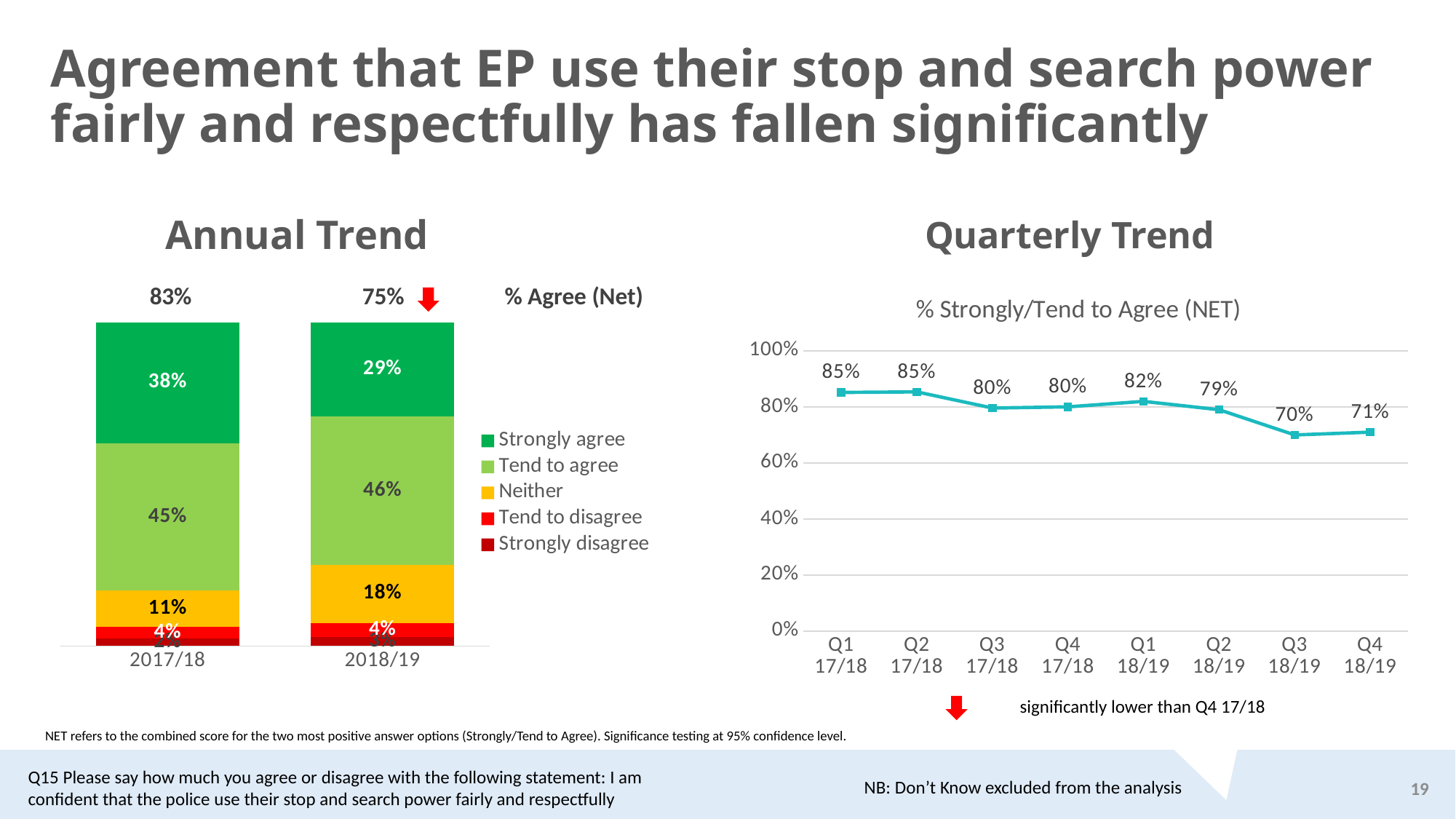
How many quarters are plotted in the Quarterly Trend chart? 8 In the Annual Trend chart, which year has the larger Tend to agree value, 2017/18 or 2018/19? 2018/19 In the Quarterly Trend chart, which quarter has the lowest value? Q3 18/19 What kind of chart is the Quarterly Trend chart? Line chart In the Annual Trend chart, what is the Strongly agree value for 2018/19? 29% How many series does the legend of the Annual Trend chart list? 5 In the Annual Trend chart, what is the % Agree (Net) for 2017/18? 83% In the Quarterly Trend chart, what is the value for Q3 18/19? 70% In the Annual Trend chart, what is the Neither value for 2018/19? 18% In the Quarterly Trend chart, what is the difference between Q1 17/18 and Q4 18/19? 14% In the Quarterly Trend chart, do the values generally rise or fall from Q1 17/18 to Q4 18/19? Fall In the Annual Trend chart, by how many percentage points did the Strongly agree value fall from 2017/18 to 2018/19? 9